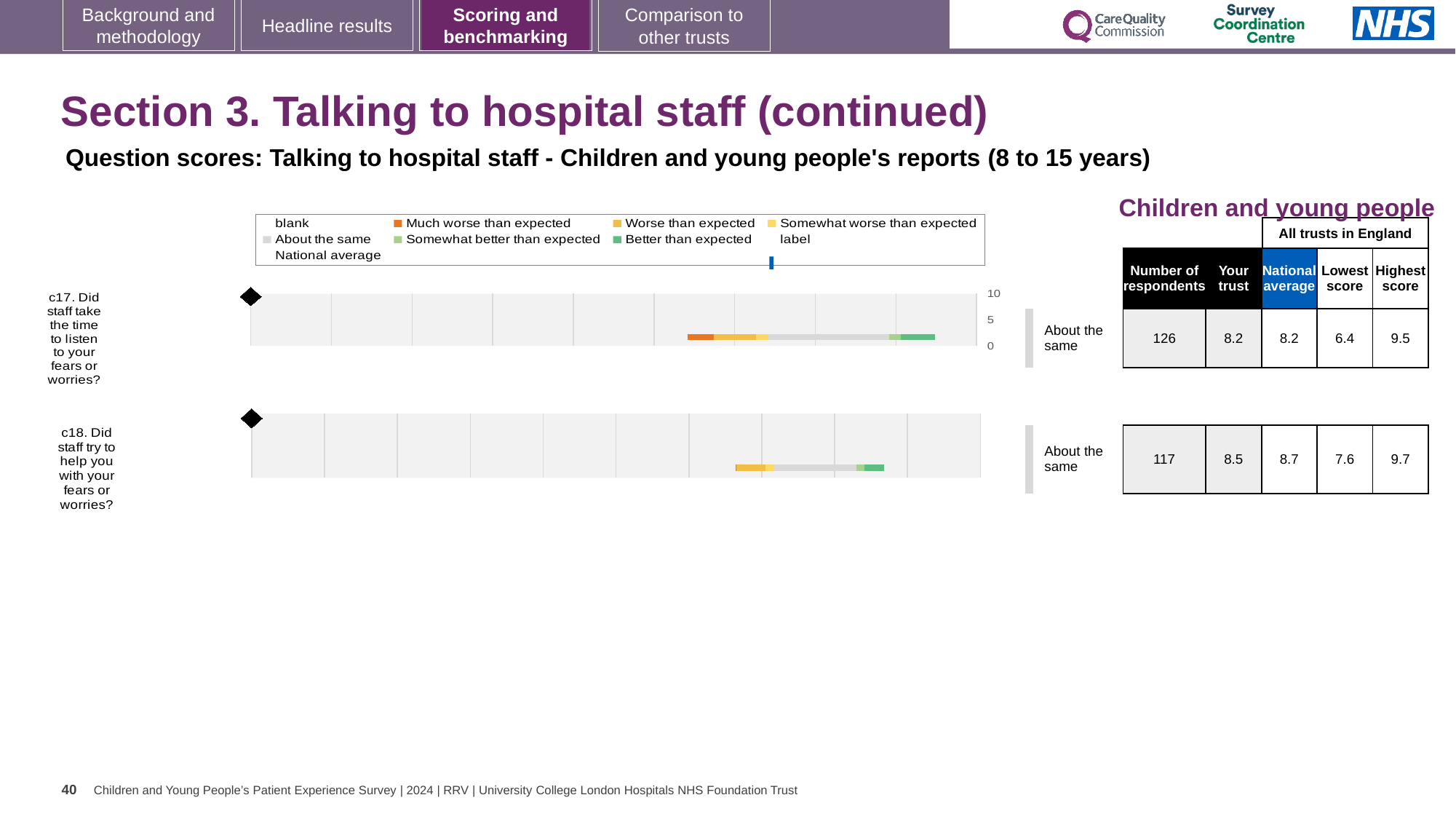
What benchmark category is shown for c17? About the same What kind of chart is used to show the question scores for c17 and c18? bar chart What is the difference between the highest score and the lowest score for c17? 3.1 How many respondents answered c17? 126 Which question has the higher 'Your trust' score, c17 or c18? c18 How many entries does the chart legend list? 9 What is the lowest score among all trusts in England for c18? 7.6 How many survey questions (categories) are plotted on the slide? 2 Which legend entry is shown in orange? Much worse than expected What is the 'Your trust' score for c17 (Did staff take the time to listen to your fears or worries?)? 8.2 What is the 'Your trust' score for c18 (Did staff try to help you with your fears or worries?)? 8.5 What is the national average score for c18? 8.7